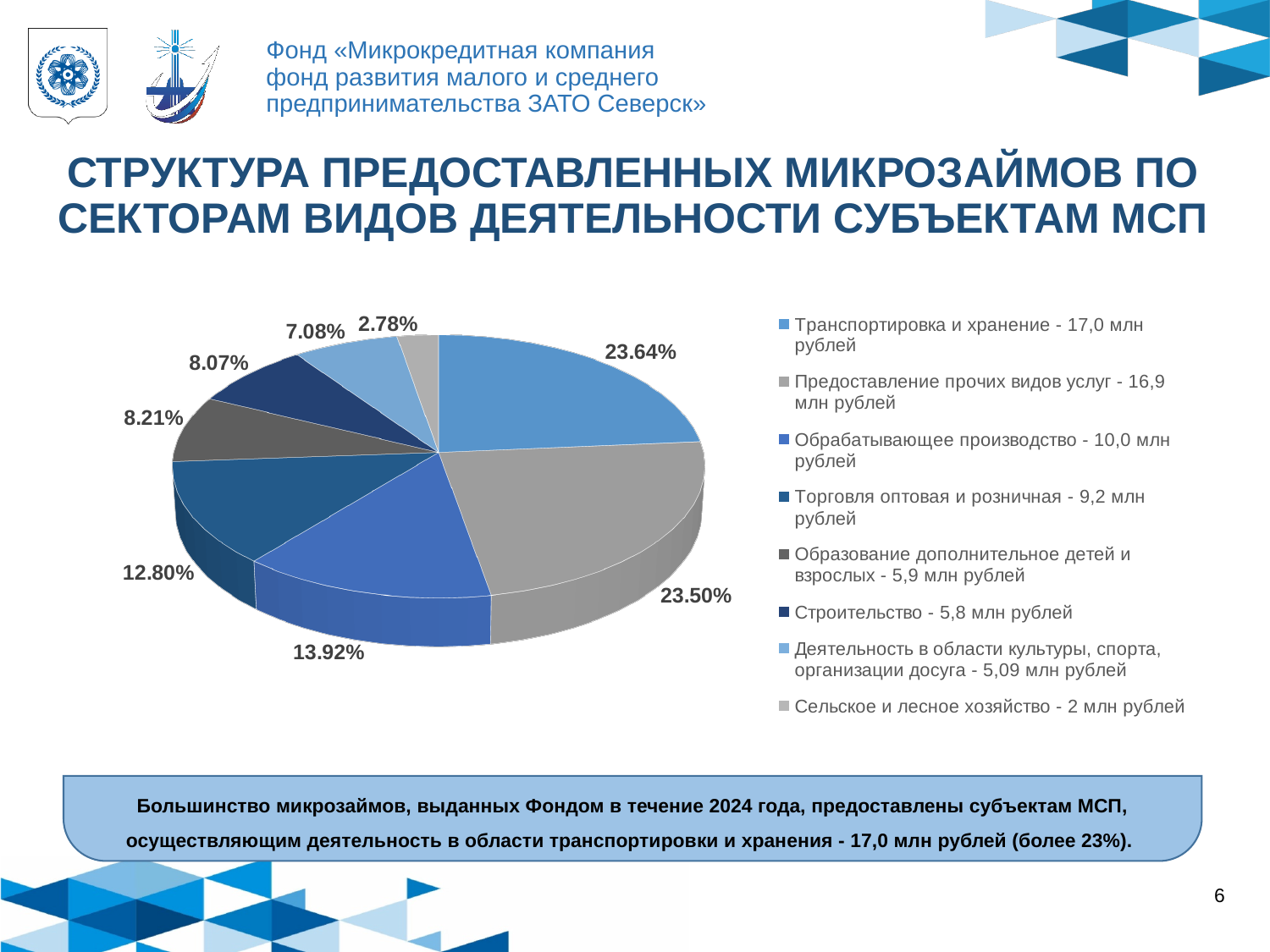
Which slice is larger: Торговля оптовая и розничная or Строительство? Торговля оптовая и розничная What share of the pie does the slice for Сельское и лесное хозяйство have? 2.78% What share of the pie does the slice for Обрабатывающее производство have? 13.92% What is the difference in percentage points between the slices for Транспортировка и хранение (23.64%) and Предоставление прочих видов услуг (23.50%)? 0.14 What share of the pie does the slice for Транспортировка и хранение have? 23.64% What kind of chart is shown on the slide? pie chart Which sector has the smallest slice of the pie? Сельское и лесное хозяйство Which sector has the largest slice of the pie? Транспортировка и хранение How many slices does the pie chart have? 8 According to the legend, how many million rubles of microloans went to Торговля оптовая и розничная? 9,2 млн рублей How many entries does the legend of the pie chart list? 8